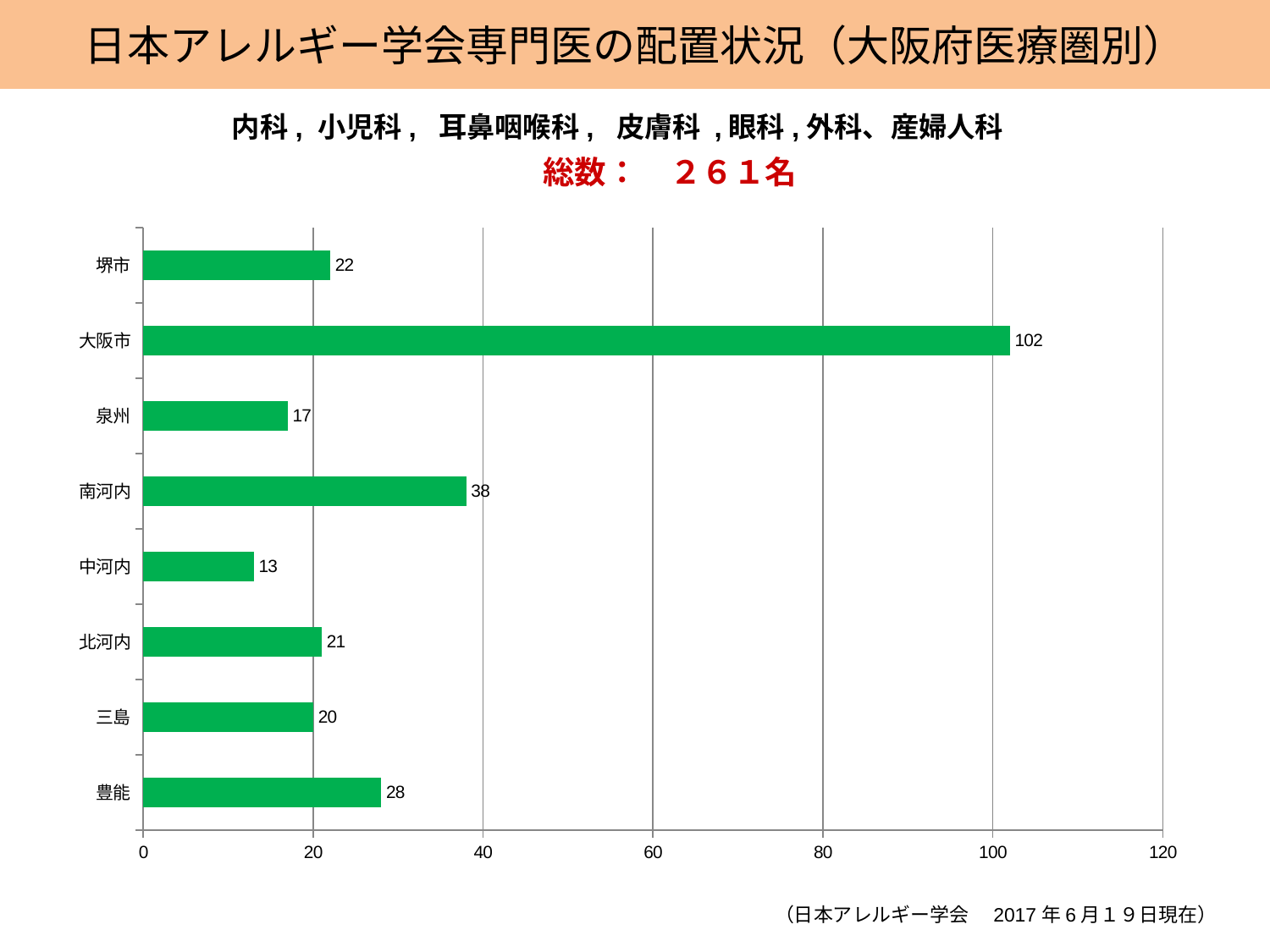
What is the maximum value shown on the horizontal axis? 120 What kind of chart is shown on the slide? bar chart What is the value for 大阪市? 102 How many categories are shown on the chart? 8 What is the value for 豊能? 28 What is the difference between the values for 堺市 and 泉州? 5 Is the value for 大阪市 greater or less than 100? greater What is the value for 南河内? 38 Which category has the lowest value? 中河内 Which category has the highest value? 大阪市 Which is larger, the value for 豊能 or the value for 三島? 豊能 What is the difference between the values for 大阪市 and 南河内? 64